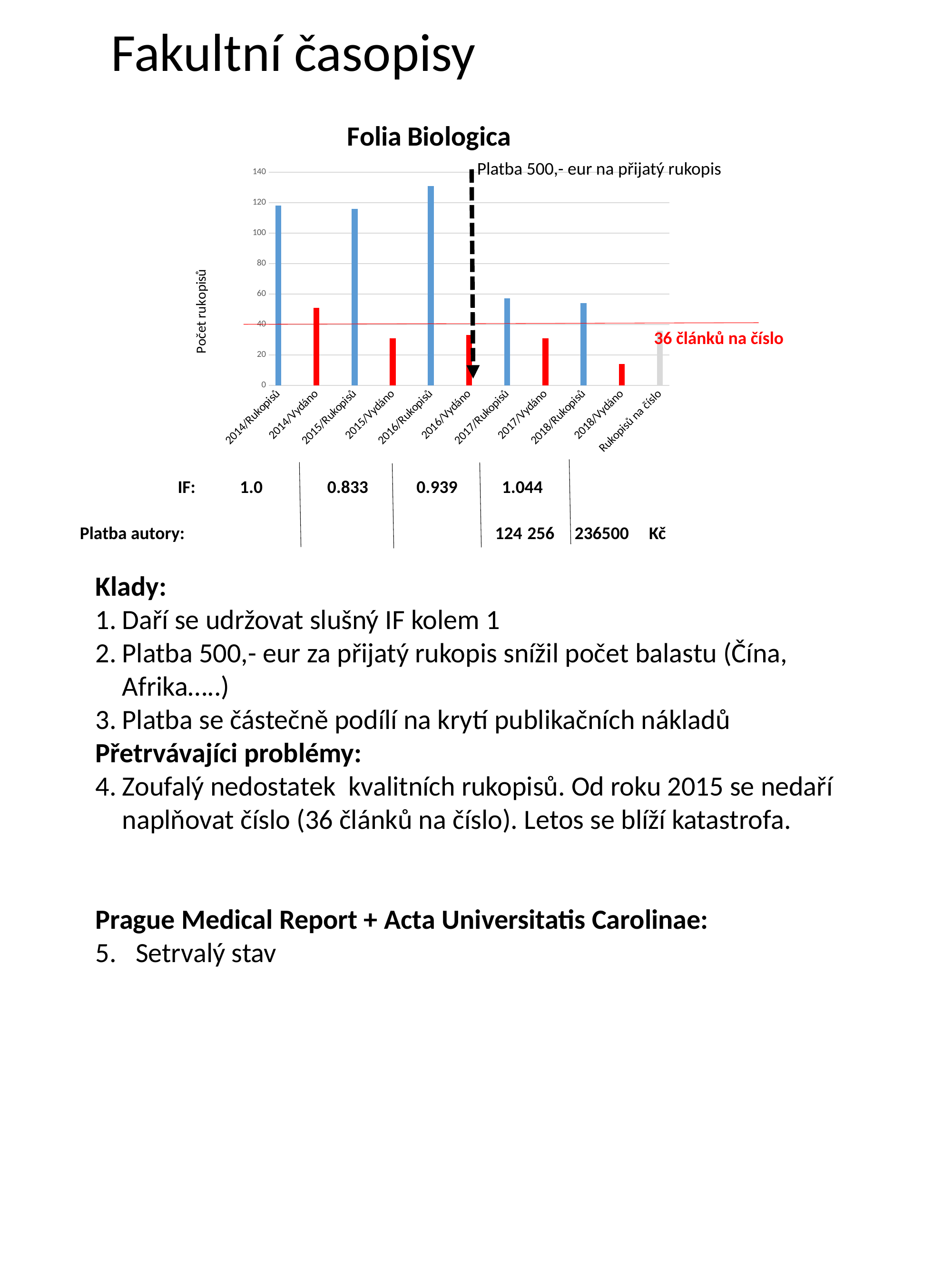
What kind of chart is shown on the slide? bar chart Which is larger, the value for 2014/Vydáno or the value for 2015/Vydáno? 2014/Vydáno Which category has the highest bar in the chart? 2016/Rukopisů Which category has the lowest bar in the chart? 2018/Vydáno Is the value for 2014/Rukopisů greater or less than 100? greater Which is larger, the value for 2014/Rukopisů or the value for 2017/Rukopisů? 2014/Rukopisů Is the value for 2018/Vydáno greater or less than 20? less How many categories are shown on the x axis of the chart? 11 What is the label of the vertical axis of the chart? Počet rukopisů Is the value for 2016/Rukopisů greater or less than 120? greater What is the title of the chart? Folia Biologica